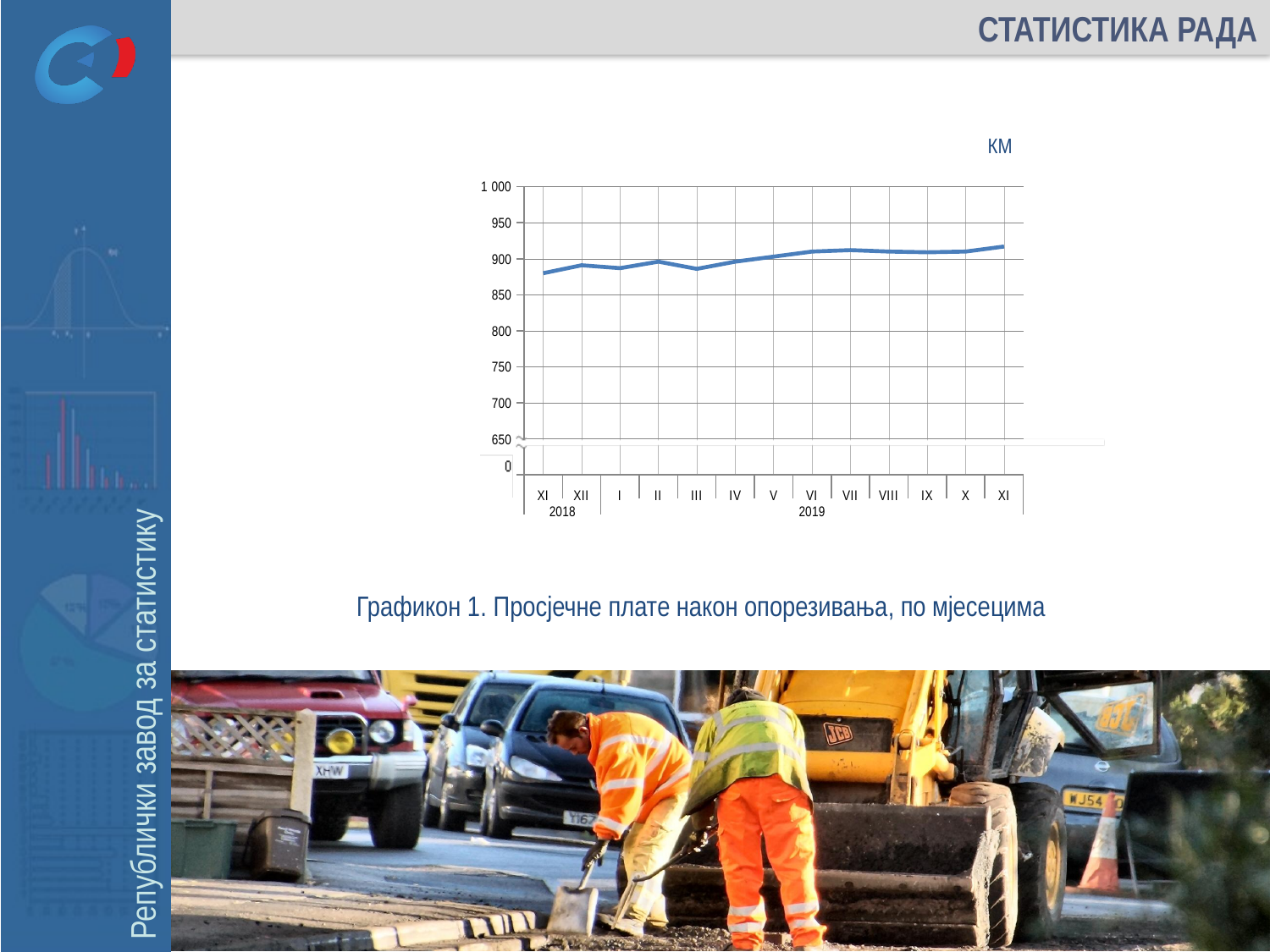
How many monthly data points are plotted on the chart? 13 Is the value for XI 2019 greater or less than 950? less What kind of chart is shown on the slide? line chart Overall, do the values rise or fall from XI 2018 to XI 2019? rise What unit is indicated above the chart? КМ Which is larger, the value for XI 2018 or the value for XI 2019? XI 2019 Is the value for VII 2019 greater or less than 900? greater Is the value for XI 2019 greater or less than 900? greater What is the title of the chart (Графикон 1)? Просјечне плате након опорезивања, по мјесецима Which month has the highest value on the chart? XI 2019